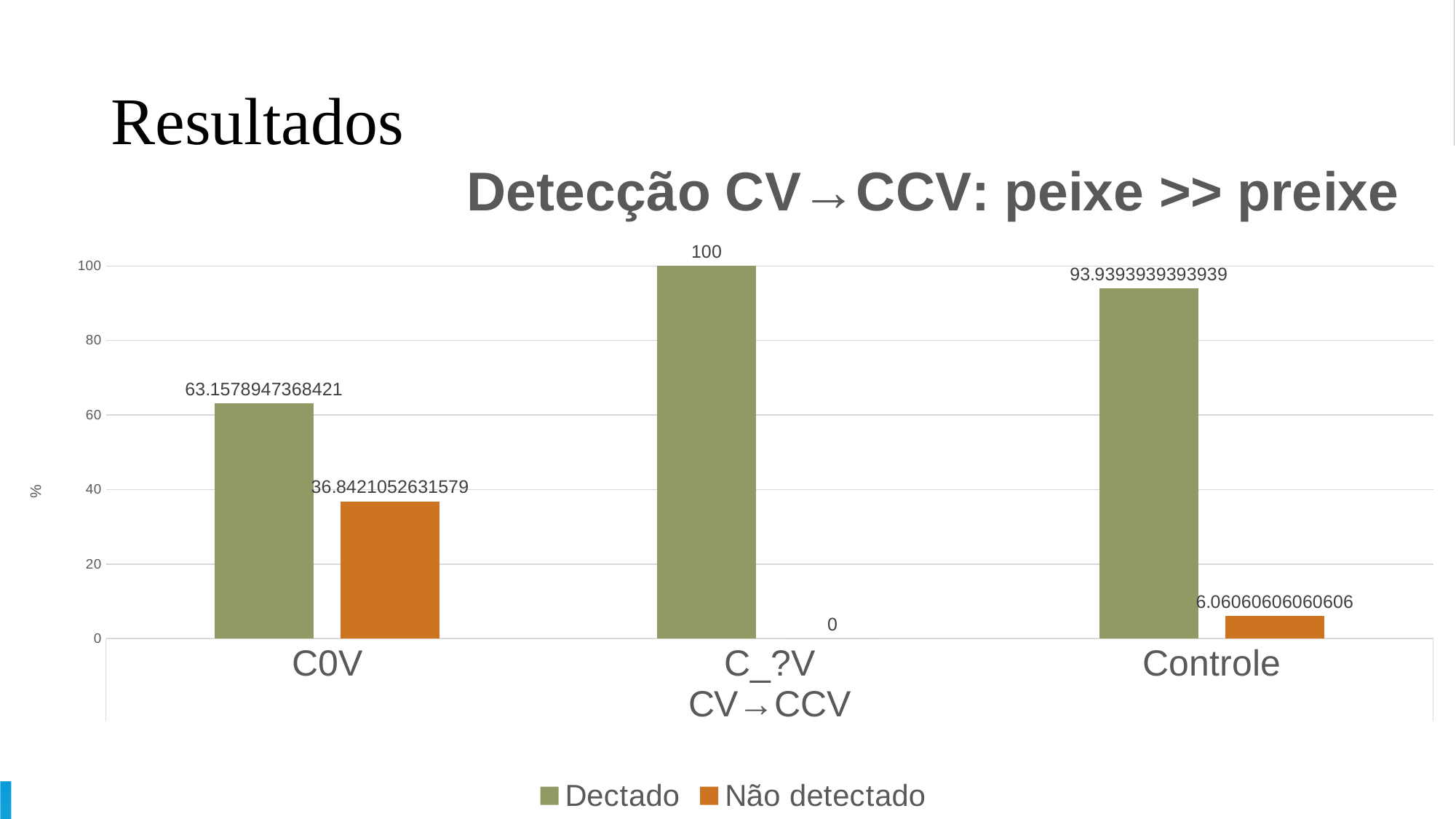
Which is larger for C0V, the Dectado value or the Não detectado value? Dectado How many series does the legend list? 2 What is the Não detectado value for C0V? 36.8421052631579 What is the Dectado value for C_?V? 100 What is the title of the chart? Detecção CV→CCV: peixe >> preixe What kind of chart is shown on the slide? bar chart Which category has the highest Dectado value? C_?V Which category has the lowest Não detectado value? C_?V What is the Dectado value for C0V? 63.1578947368421 What is the Não detectado value for Controle? 6.06060606060606 Is the Dectado value for Controle greater or less than 80? greater How many categories are shown on the x axis? 3